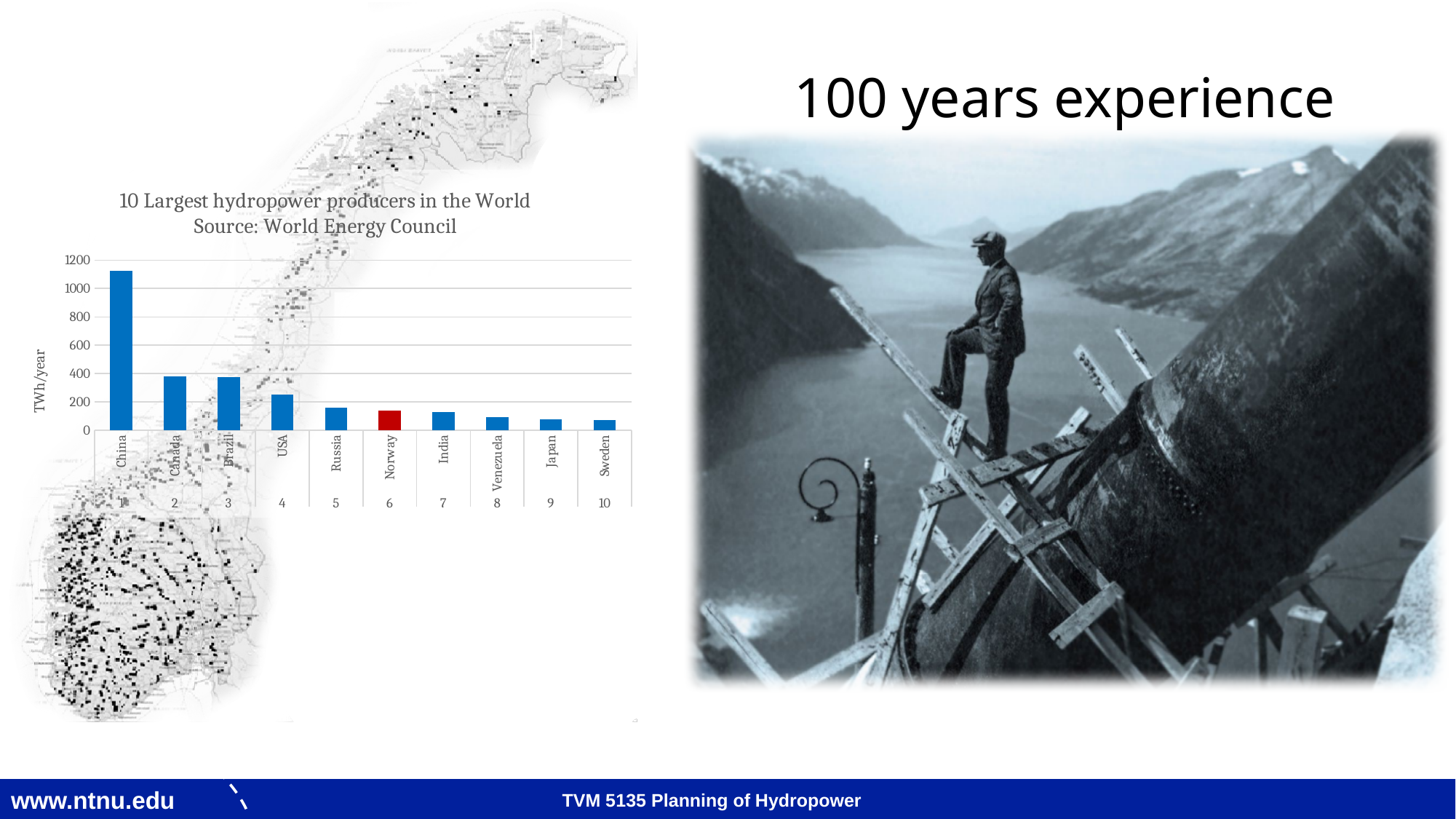
What is the title of the chart? 10 Largest hydropower producers in the World What kind of chart is shown on the slide? bar chart Which has a larger value, USA or Russia? USA Which country has the highest hydropower production in the chart? China How many countries are shown in the chart? 10 Do the values rise or fall from left to right along the x axis? fall Is the value for USA greater or less than 200 TWh/year? greater Is the value for Norway greater or less than 200 TWh/year? less Which country's bar is coloured red in the chart? Norway Which has a larger value, Canada or India? Canada Is the value for China greater or less than 1000 TWh/year? greater